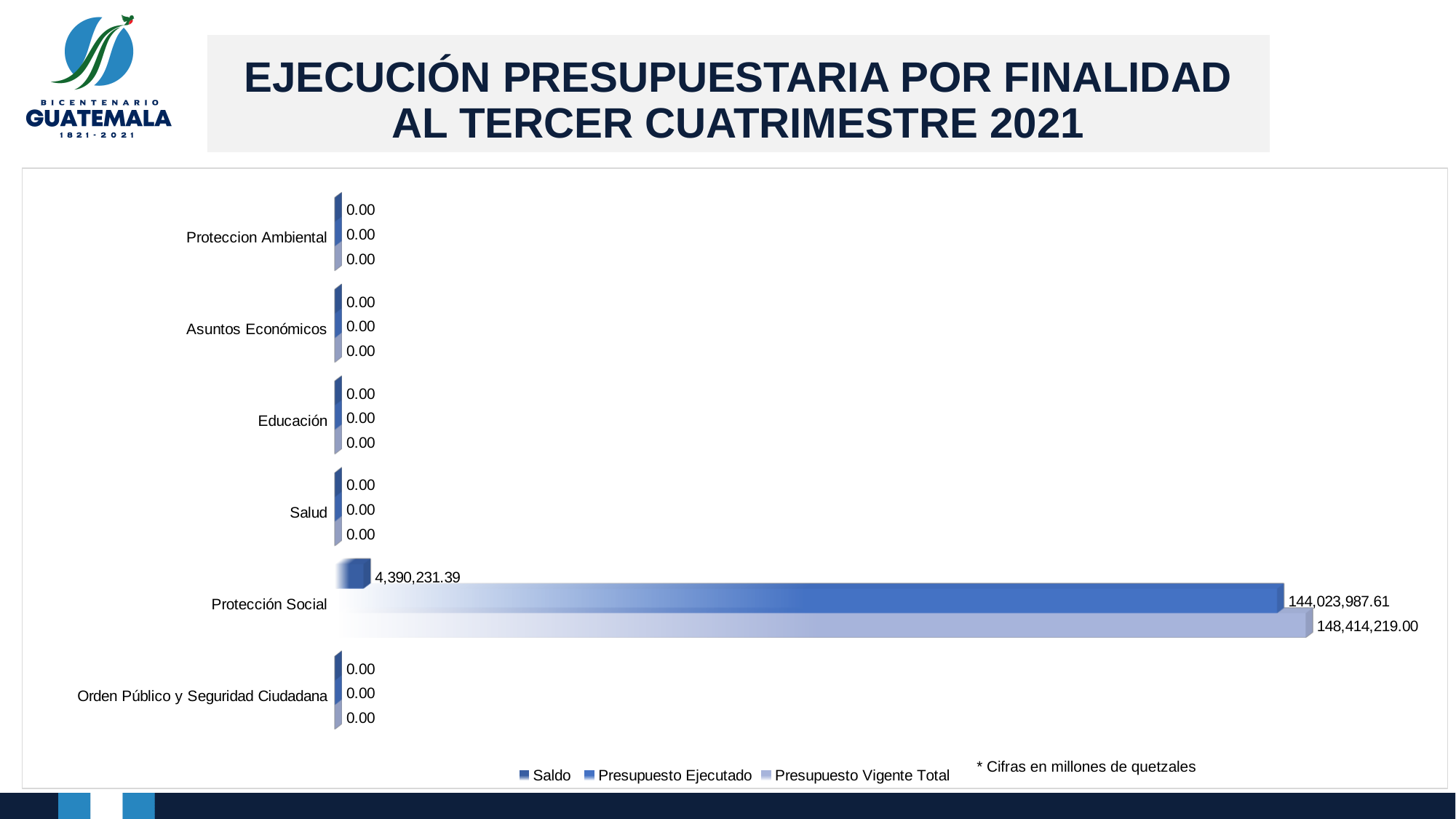
What is the Presupuesto Vigente Total value for Protección Social? 148,414,219.00 What is the Presupuesto Ejecutado value for Educación? 0.00 How many categories are shown on the chart? 6 Which category has the highest Presupuesto Vigente Total? Protección Social How many series does the legend list? 3 What is the value of Saldo for Orden Público y Seguridad Ciudadana? 0.00 What is the Presupuesto Ejecutado value for Protección Social? 144,023,987.61 What kind of chart is shown on the slide? Bar chart What are the three series listed in the legend? Saldo, Presupuesto Ejecutado, Presupuesto Vigente Total What is the Saldo value for Protección Social? 4,390,231.39 For Protección Social, which is larger: Presupuesto Ejecutado or Presupuesto Vigente Total? Presupuesto Vigente Total What is the difference between the Presupuesto Vigente Total and the Presupuesto Ejecutado for Protección Social? 4,390,231.39